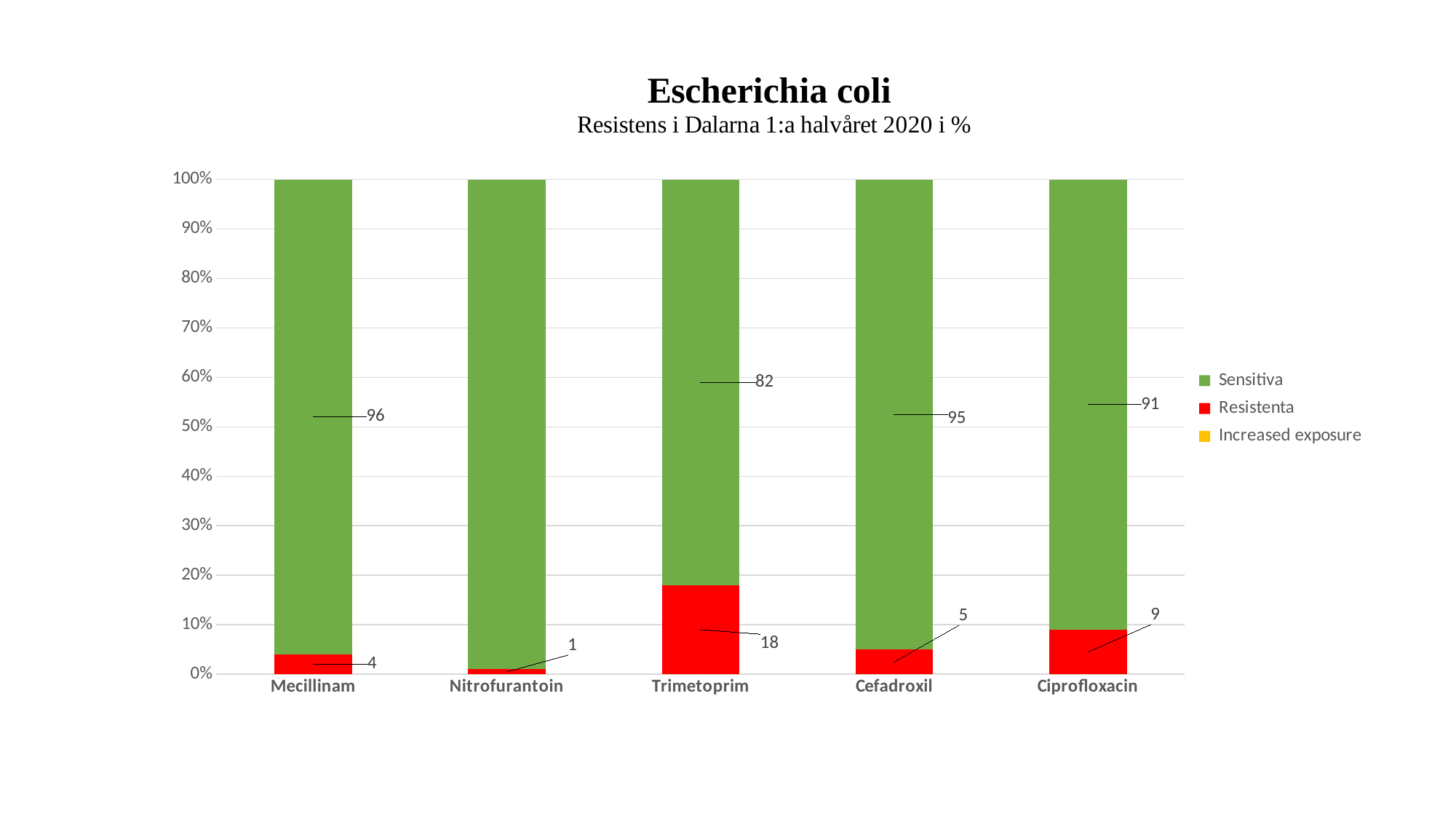
Which has a larger Resistenta value, Ciprofloxacin or Mecillinam? Ciprofloxacin What is the Resistenta value for Nitrofurantoin? 1 What is the Resistenta value for Trimetoprim? 18 What is the difference between the Resistenta values for Trimetoprim and Cefadroxil? 13 How many series does the legend list? 3 What kind of chart is shown? Stacked bar chart What is the Sensitiva value for Mecillinam? 96 What is the subtitle of the chart? Resistens i Dalarna 1:a halvåret 2020 i % How many antibiotics are shown on the x axis? 5 Which antibiotic has the lowest Resistenta value? Nitrofurantoin What is the Sensitiva value for Ciprofloxacin? 91 Which antibiotic has the highest Resistenta value? Trimetoprim